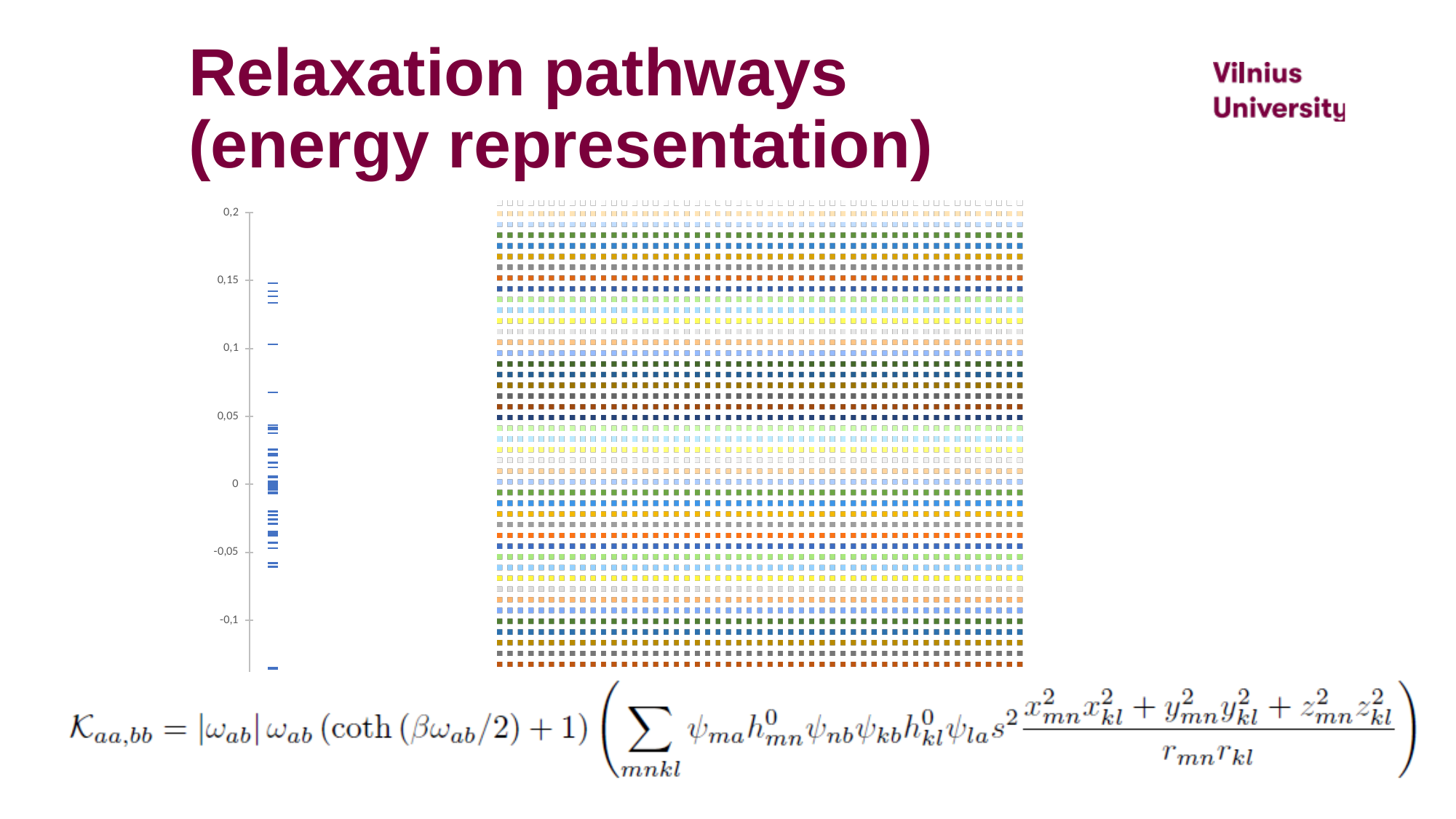
Is the lowest plotted marker in the chart greater or less than -0,1? less What is the lowest value labelled on the vertical axis of the chart? -0,1 What is the highest value labelled on the vertical axis of the chart? 0,2